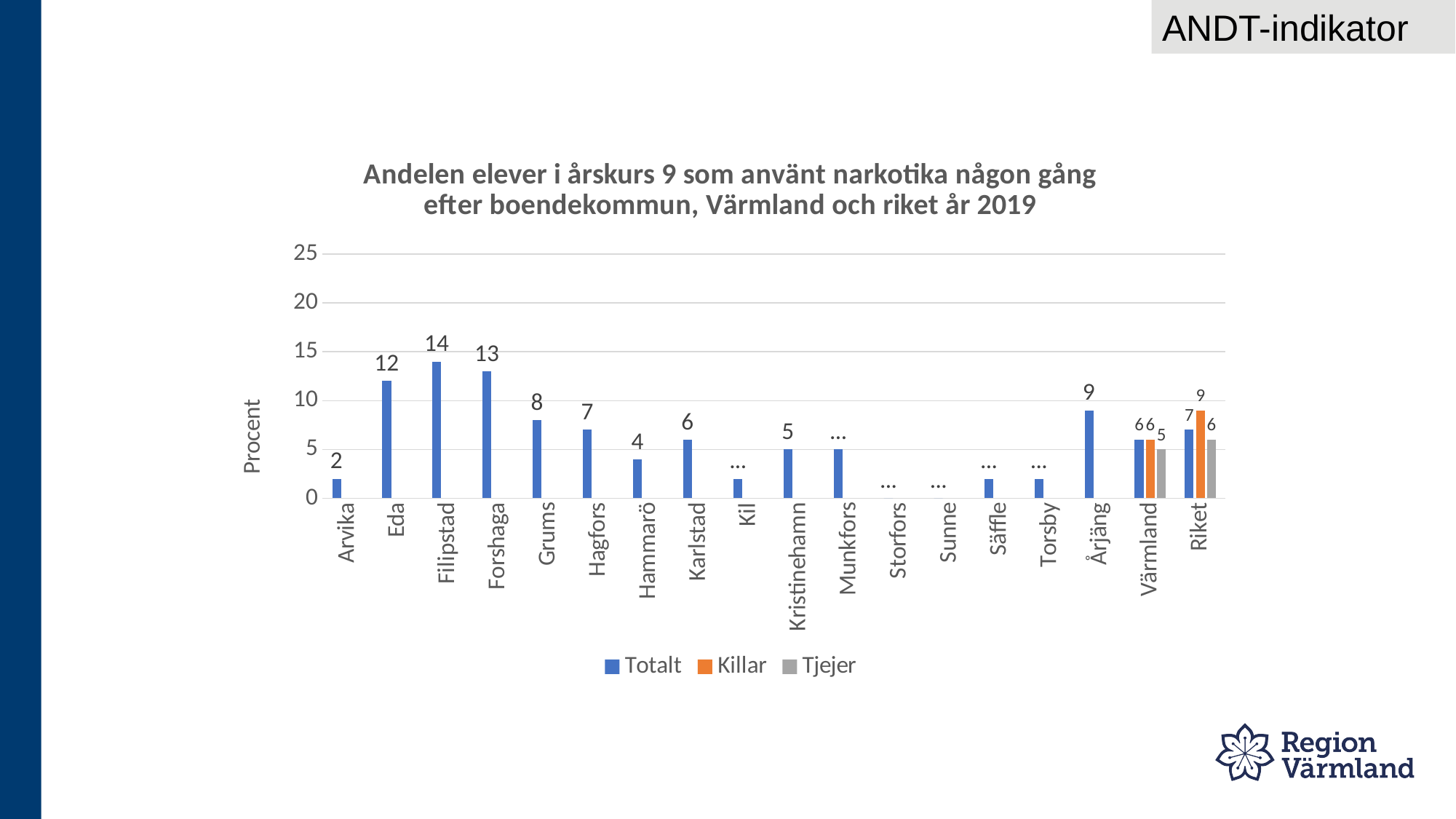
Which has a larger Totalt value, Hagfors or Hammarö? Hagfors What is the difference between the Killar and Tjejer values for Riket? 3 How many categories are shown on the x axis? 18 What is the Totalt value for Filipstad? 14 What kind of chart is shown on the slide? bar chart Is the Totalt value for Kil greater or less than 5? less What is the Tjejer value for Värmland? 5 What is the Totalt value for Eda? 12 What is the difference between the Totalt values for Eda and Grums? 4 Which municipality has the highest Totalt value? Filipstad How many series does the legend list? 3 What is the Killar value for Riket? 9